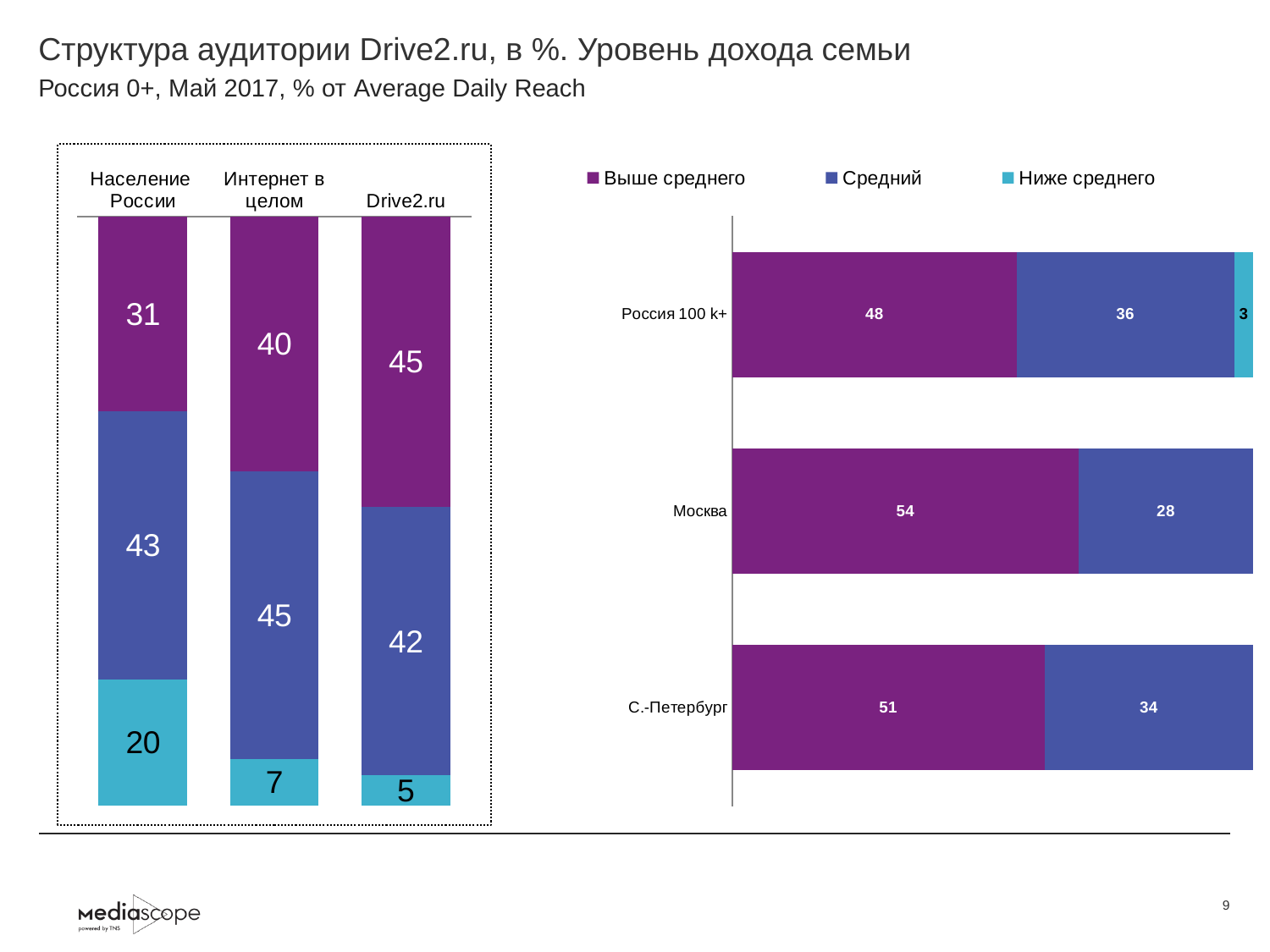
How many series does the legend list? 3 In the left chart, which category has the highest 'Выше среднего' value? Drive2.ru In the left chart, what is the difference between the 'Выше среднего' values for 'Drive2.ru' and 'Население России'? 14 In the right chart, what is the 'Средний' value for 'С.-Петербург'? 34 In the left chart, what is the value of the 'Выше среднего' segment for 'Drive2.ru'? 45 What type of chart is the right chart? Stacked bar chart In the left chart, what is the value of the 'Средний' segment for 'Интернет в целом'? 45 In the right chart, what is the 'Выше среднего' value for 'Москва'? 54 In the right chart, what is the 'Ниже среднего' value for 'Россия 100 k+'? 3 In the right chart, which is larger: the 'Средний' value for 'Россия 100 k+' or for 'Москва'? Россия 100 k+ In the left chart, what is the value of the 'Ниже среднего' segment for 'Население России'? 20 In the left chart, which category has the lowest 'Ниже среднего' value? Drive2.ru